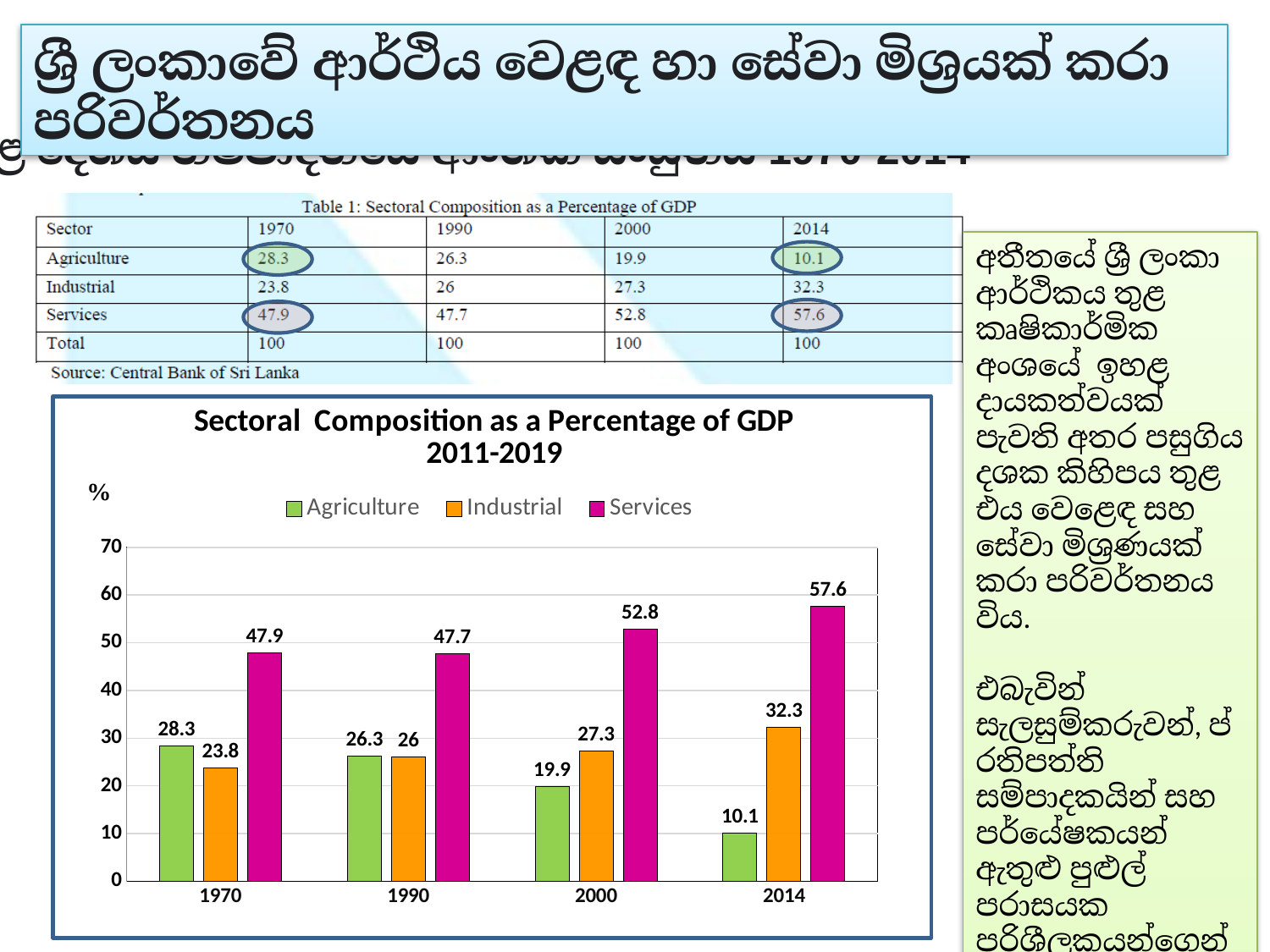
What type of chart is shown on the slide? bar chart What is the value for Industrial in 2000? 27.3 What is the value for Agriculture in 1970? 28.3 Does the Agriculture value rise or fall from 1970 to 2014? fall Which is larger in 1990, Agriculture or Industrial? Agriculture What is the value for Services in 2014? 57.6 How many series does the chart legend list? 3 What is the difference between the Services value and the Agriculture value in 2014? 47.5 In which year is the Agriculture value lowest? 2014 How many year categories are shown on the x axis of the chart? 4 In which year is the Services value highest? 2014 Which series is shown in orange in the chart? Industrial